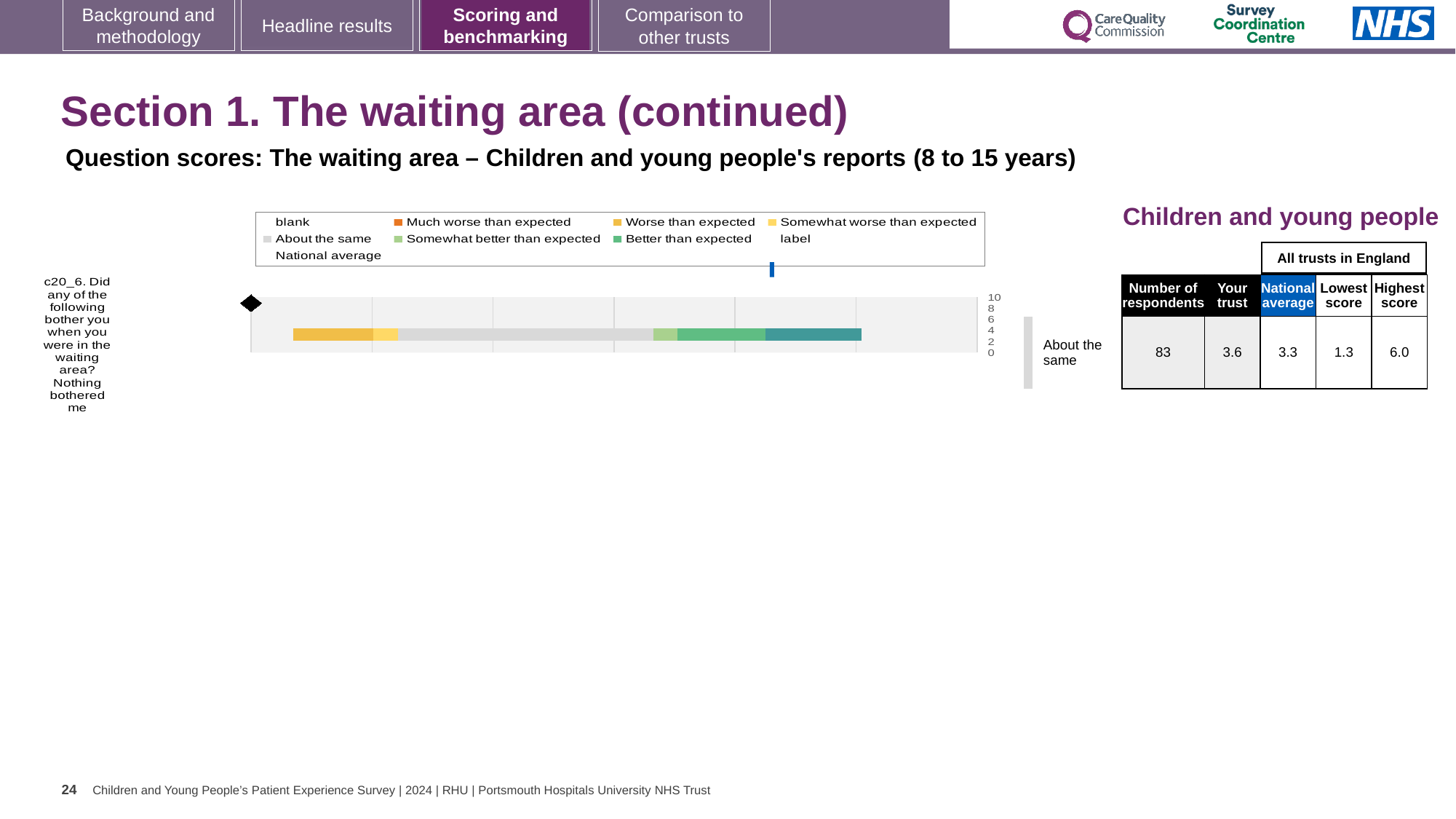
According to the table beside the chart, what is the lowest score among all trusts in England for question c20_6? 1.3 What is the difference between the 'Your trust' score and the national average for question c20_6? 0.3 According to the table beside the chart, what is the 'Your trust' score for question c20_6? 3.6 Which is larger for question c20_6: the 'Your trust' score or the national average? Your trust What is the highest value shown on the chart's numeric axis? 10 According to the table beside the chart, what is the national average score for question c20_6? 3.3 According to the table beside the chart, what is the highest score among all trusts in England for question c20_6? 6.0 Which benchmark category label is shown next to the chart for question c20_6? About the same What is the difference between the highest score and the lowest score among all trusts in England for question c20_6? 4.7 How many survey questions (categories) are plotted in the chart? 1 What kind of chart is shown on the slide for question c20_6? bar chart How many respondents answered question c20_6, according to the table beside the chart? 83